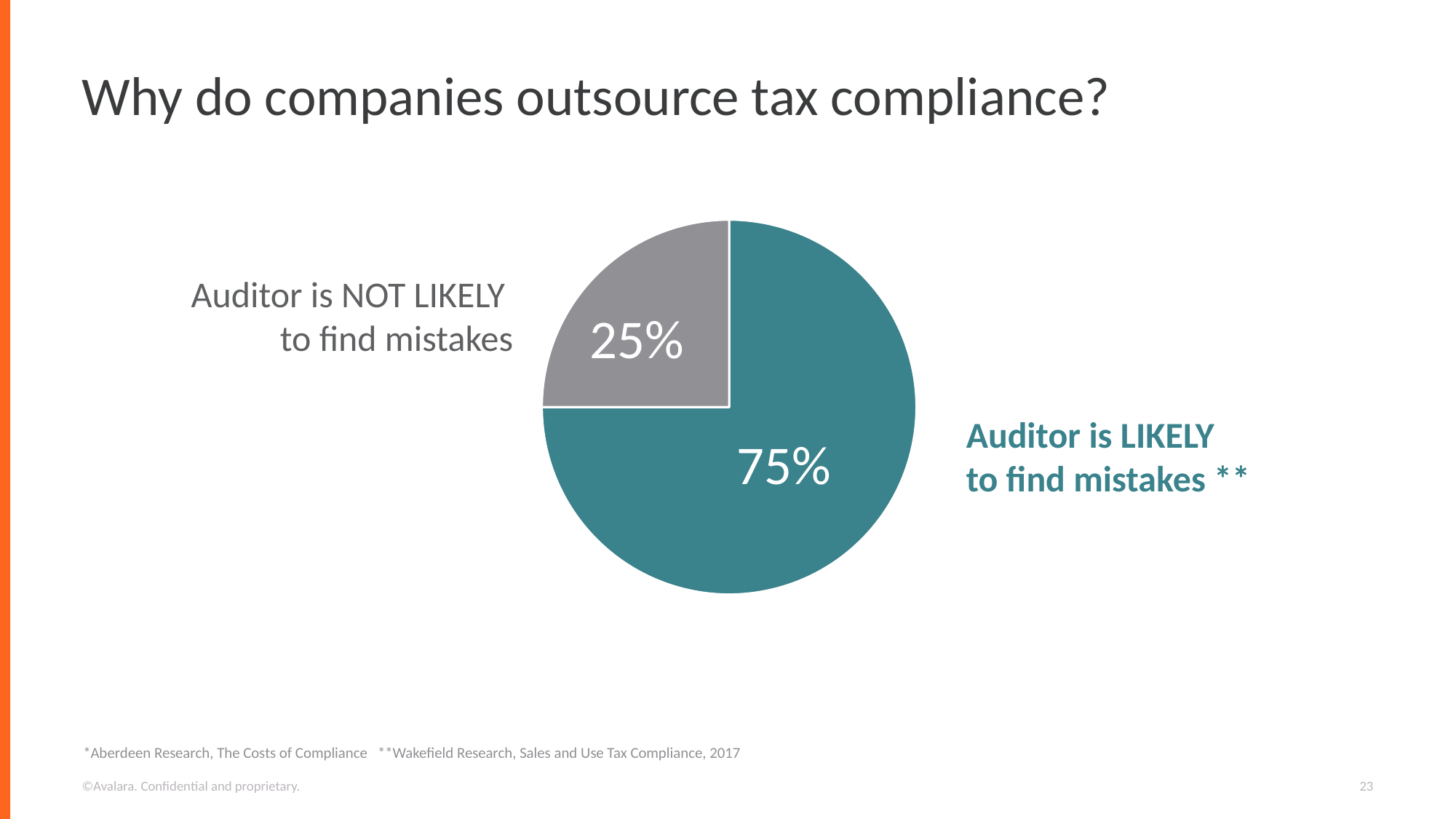
Which is larger: the 'Auditor is LIKELY to find mistakes' slice or the 'Auditor is NOT LIKELY to find mistakes' slice? Auditor is LIKELY to find mistakes What kind of chart is shown on the slide? pie chart What share of the pie does the 'Auditor is NOT LIKELY to find mistakes' slice represent? 25% How many slices does the pie chart have? 2 What colour is the 'Auditor is NOT LIKELY to find mistakes' slice? gray Which slice of the pie is the smallest? Auditor is NOT LIKELY to find mistakes What percentage of the pie corresponds to 'Auditor is NOT LIKELY to find mistakes'? 25% What is the difference in percentage points between the 'LIKELY' and 'NOT LIKELY' slices? 50 Which slice of the pie is the largest? Auditor is LIKELY to find mistakes What colour is the 'Auditor is LIKELY to find mistakes' slice? teal What percentage of the pie corresponds to 'Auditor is LIKELY to find mistakes'? 75%